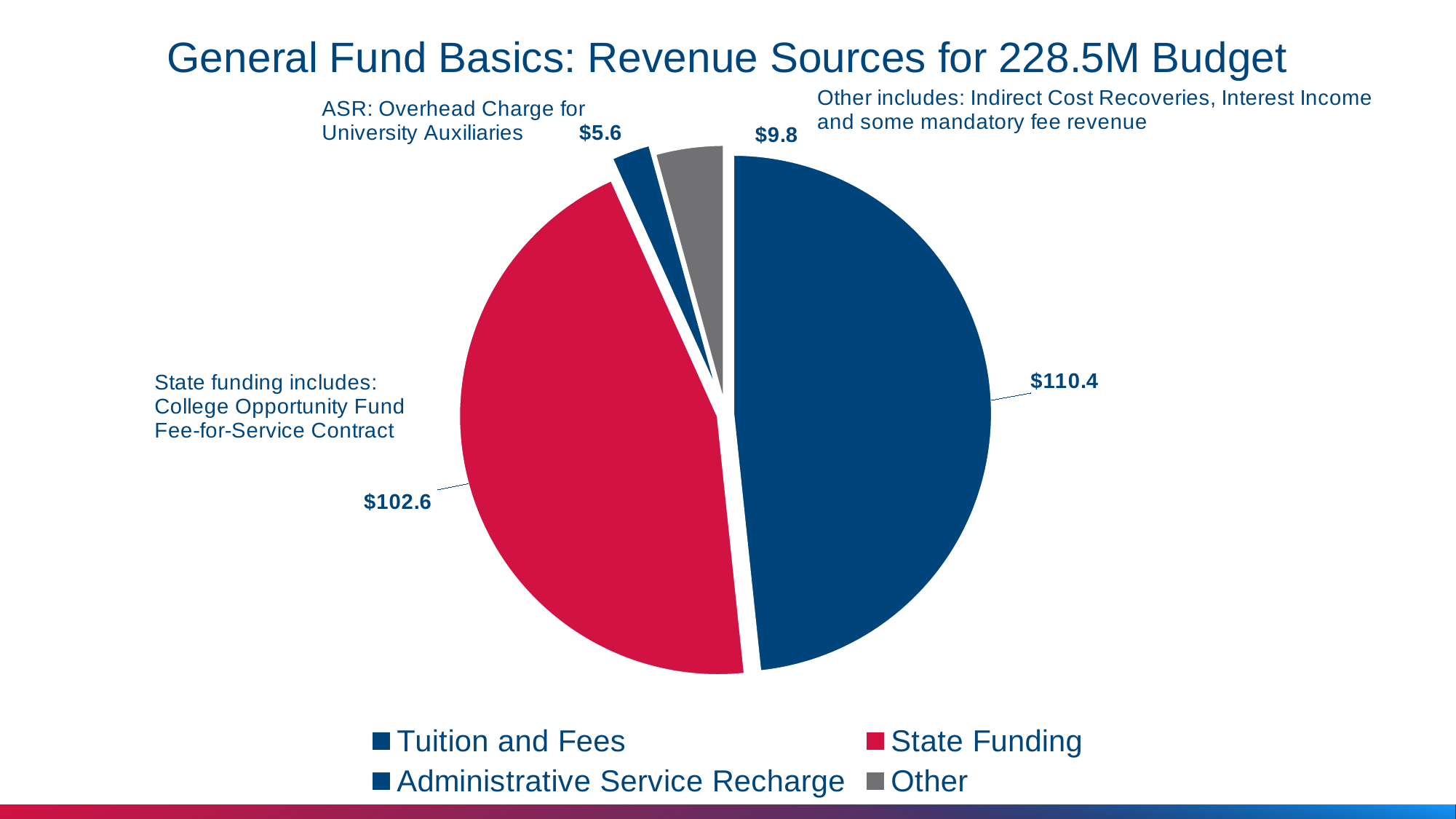
What is the value for Tuition and Fees? $110.4 What is the value for Other? $9.8 What is the value for Administrative Service Recharge? $5.6 How many revenue sources are shown in the pie chart? 4 What is the difference between Other and Administrative Service Recharge? $4.2 What type of chart is shown on the slide? Pie chart Which revenue source has the smallest slice? Administrative Service Recharge What is the difference between Tuition and Fees and State Funding? $7.8 Which is larger, Other or Administrative Service Recharge? Other What is the title of the slide? General Fund Basics: Revenue Sources for 228.5M Budget What is the value for State Funding? $102.6 Which revenue source has the largest slice? Tuition and Fees